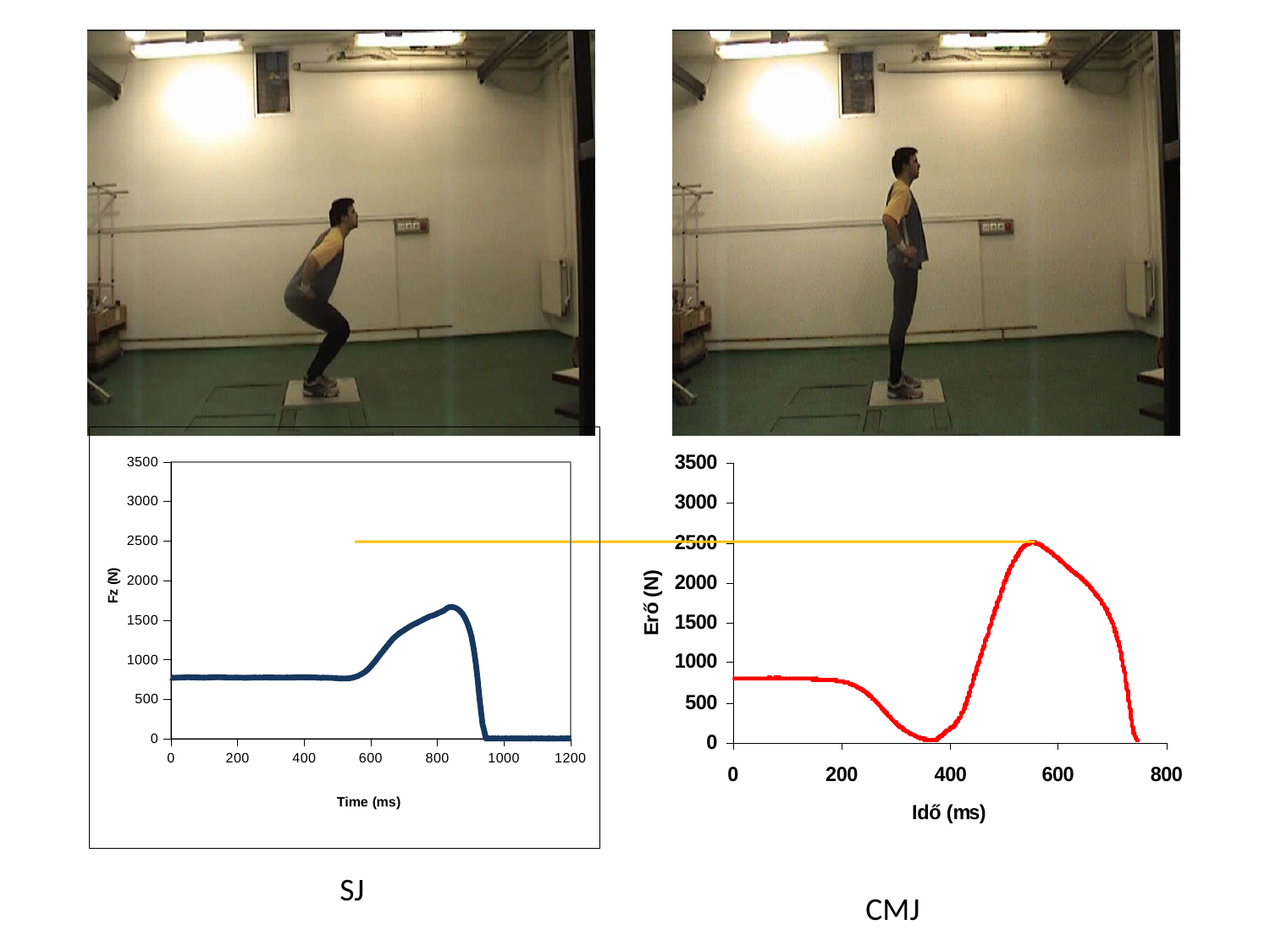
On the SJ chart, is the value at time 0 greater or less than 500? greater What type of chart is the SJ chart on the left? line chart On the CMJ chart, is the lowest value of the curve (around 400 ms) greater or less than 500? less On the CMJ chart, does the curve rise or fall between 200 ms and 400 ms? fall On the CMJ chart, is the peak value of the curve greater or less than 2000? greater Which chart shows the higher peak force, the SJ chart or the CMJ chart? CMJ On the SJ chart, what is the label of the y-axis? Fz (N) On the CMJ chart, what is the label of the x-axis? Idő (ms) What type of chart is the CMJ chart on the right? line chart